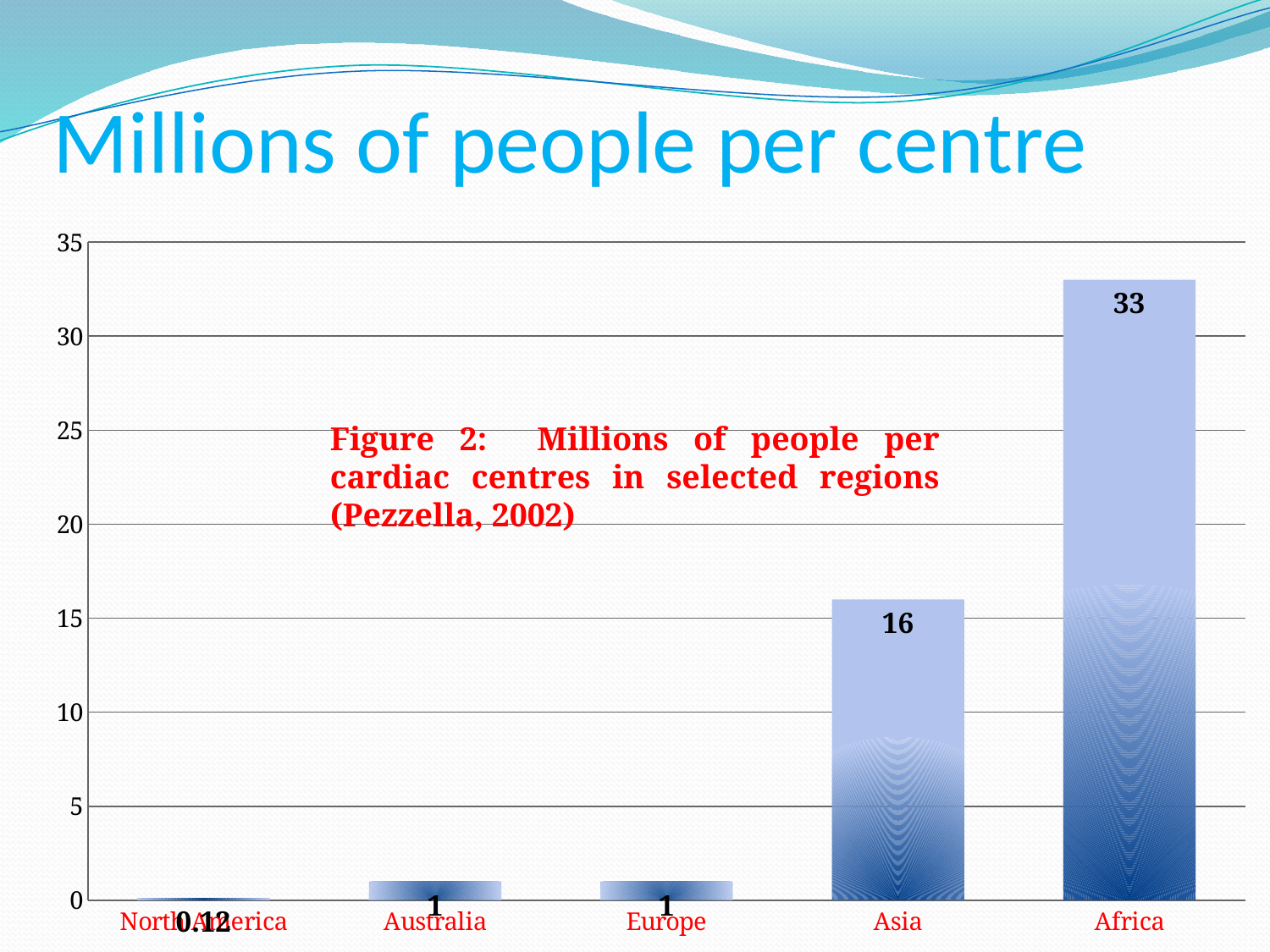
Is the value for Africa greater or less than 30? greater What kind of chart is shown? bar chart What is the value for Africa? 33 Which region has the highest value? Africa How many regions are shown on the x axis? 5 Which region has the lowest value? North America What is the value for North America? 0.12 What is the value for Asia? 16 What is the value for Australia? 1 What is the title of the chart? Millions of people per centre Which is larger, the value for Asia or the value for Europe? Asia What is the difference between the values for Africa and Asia? 17